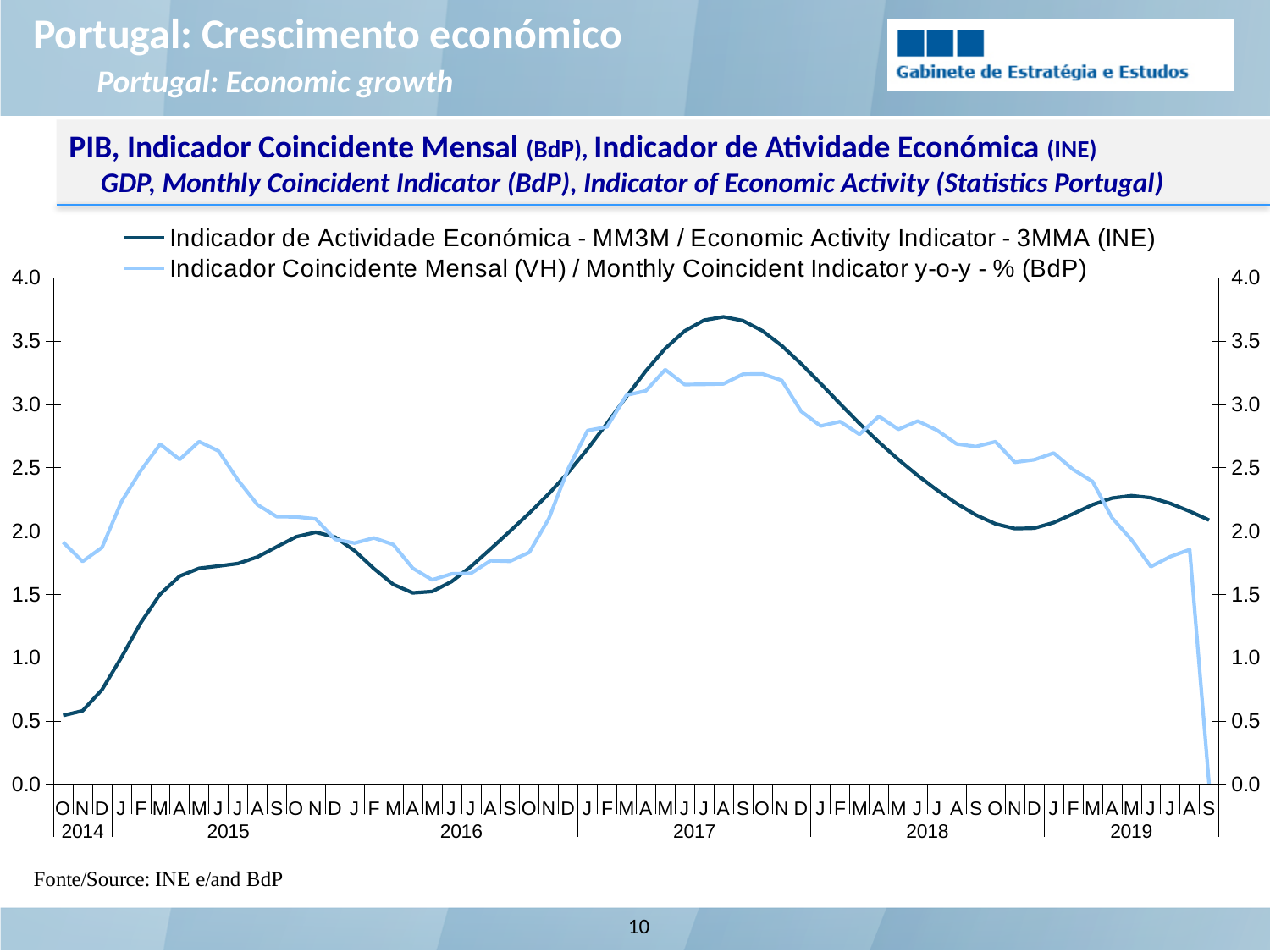
How many series does the legend list? 2 Which series is drawn in the darker blue line? Indicador de Actividade Económica - MM3M / Economic Activity Indicator - 3MMA (INE) At the last point (September 2019), which series has the higher value? Economic Activity Indicator - 3MMA (INE) Is the peak value of the Monthly Coincident Indicator y-o-y (BdP) line during 2015 greater or less than 2.5? greater Is the peak value of the Economic Activity Indicator - 3MMA (INE) line in 2017 greater or less than 3.5? greater Is the value of the Monthly Coincident Indicator y-o-y (BdP) line at its last point (September 2019) greater or less than 0.5? less Which series reaches the higher peak value over the whole period? Economic Activity Indicator - 3MMA (INE) What is the source cited below the chart? INE e/and BdP Does the Economic Activity Indicator - 3MMA (INE) line rise or fall from October 2014 to its peak in 2017? rise In which year does the Economic Activity Indicator - 3MMA (INE) line reach its highest value? 2017 What kind of chart is shown on the slide? Line chart